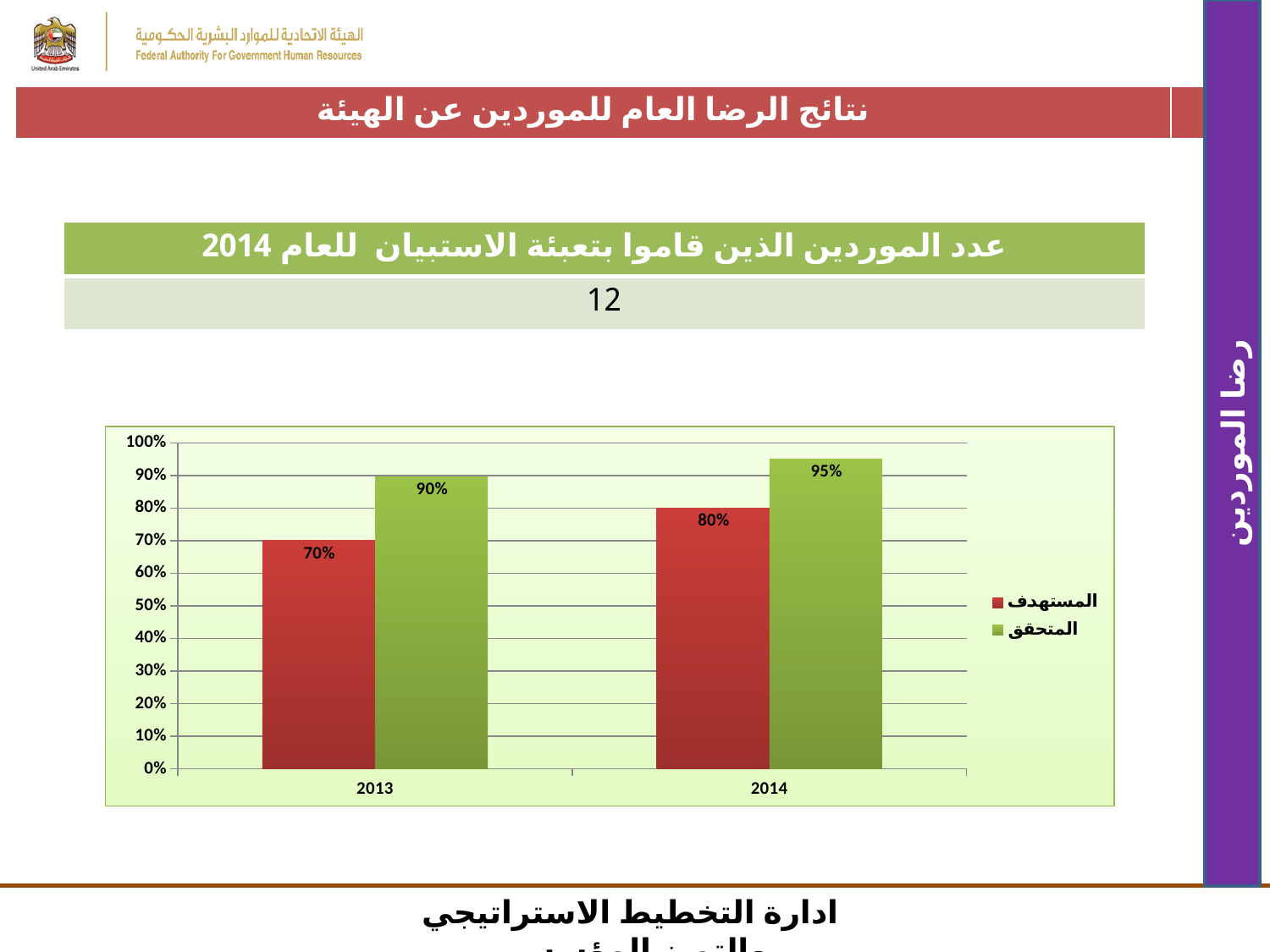
Which year has the lowest value for المستهدف? 2013 Does the value of المستهدف rise or fall from 2013 to 2014? Rise What is the value of المتحقق for 2014? 95% What is the difference between المتحقق and المستهدف in 2013? 20% What is the value of المستهدف for 2014? 80% What is the value of المتحقق for 2013? 90% What is the value of المستهدف for 2013? 70% How many series does the legend list? 2 Which is larger in 2014, المستهدف or المتحقق? المتحقق Which year has the highest value for المتحقق? 2014 What is the difference between المتحقق and المستهدف in 2014? 15% What kind of chart is shown on the slide? Bar chart